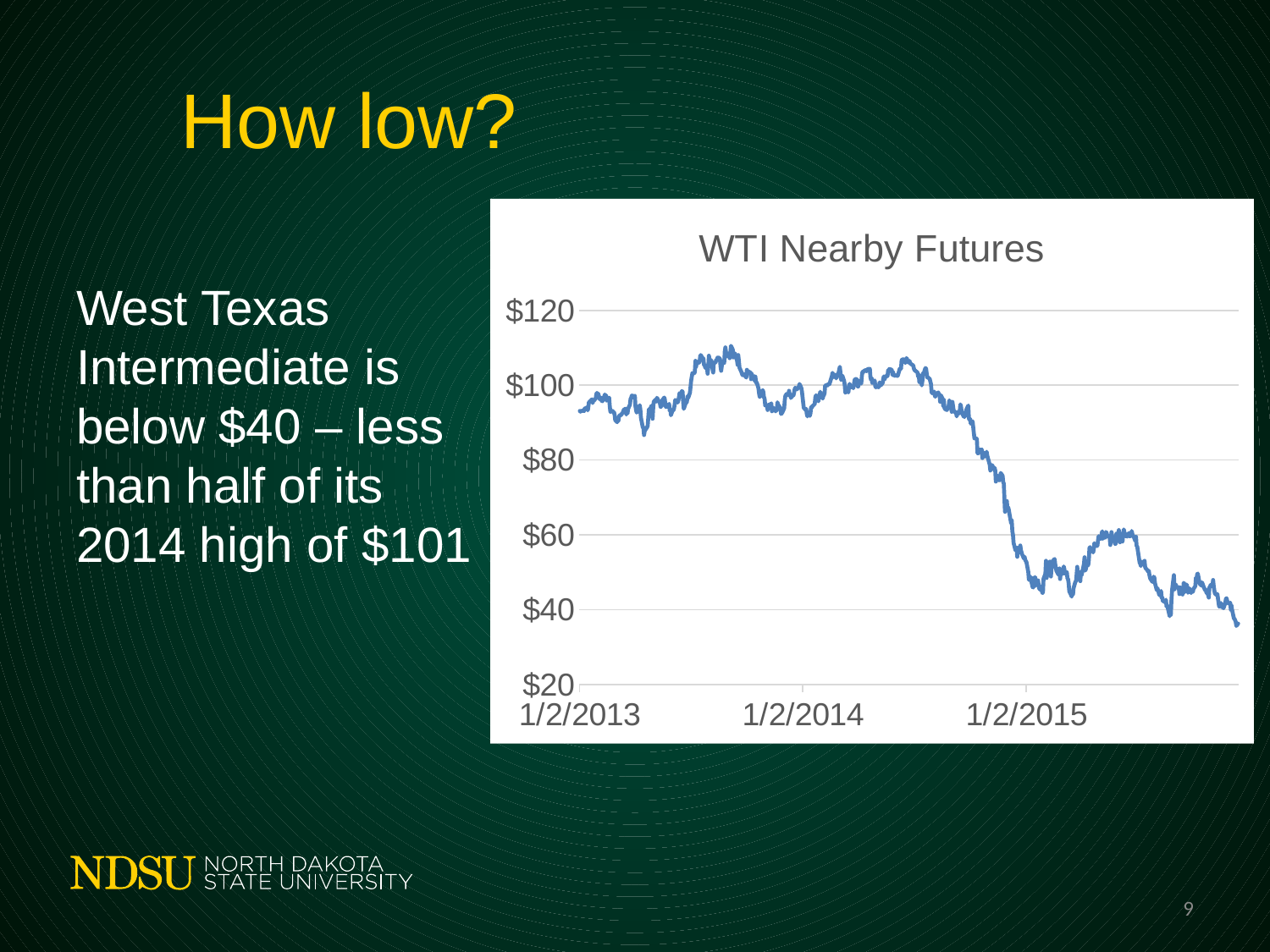
Is the value at the end of the series (right edge of the chart) greater or less than $40? less Is the highest point on the line greater or less than $100? greater How many lines are plotted on the chart? 1 Is the value at 1/2/2015 greater or less than $40? greater What kind of chart is shown on the slide? line chart How many date labels are shown on the x axis? 3 What is the highest value labelled on the y axis? $120 What is the title of the chart? WTI Nearby Futures Which is larger, the value at 1/2/2014 or the value at 1/2/2015? 1/2/2014 Overall, does the WTI Nearby Futures line rise or fall from 1/2/2013 to the end of the series? fall